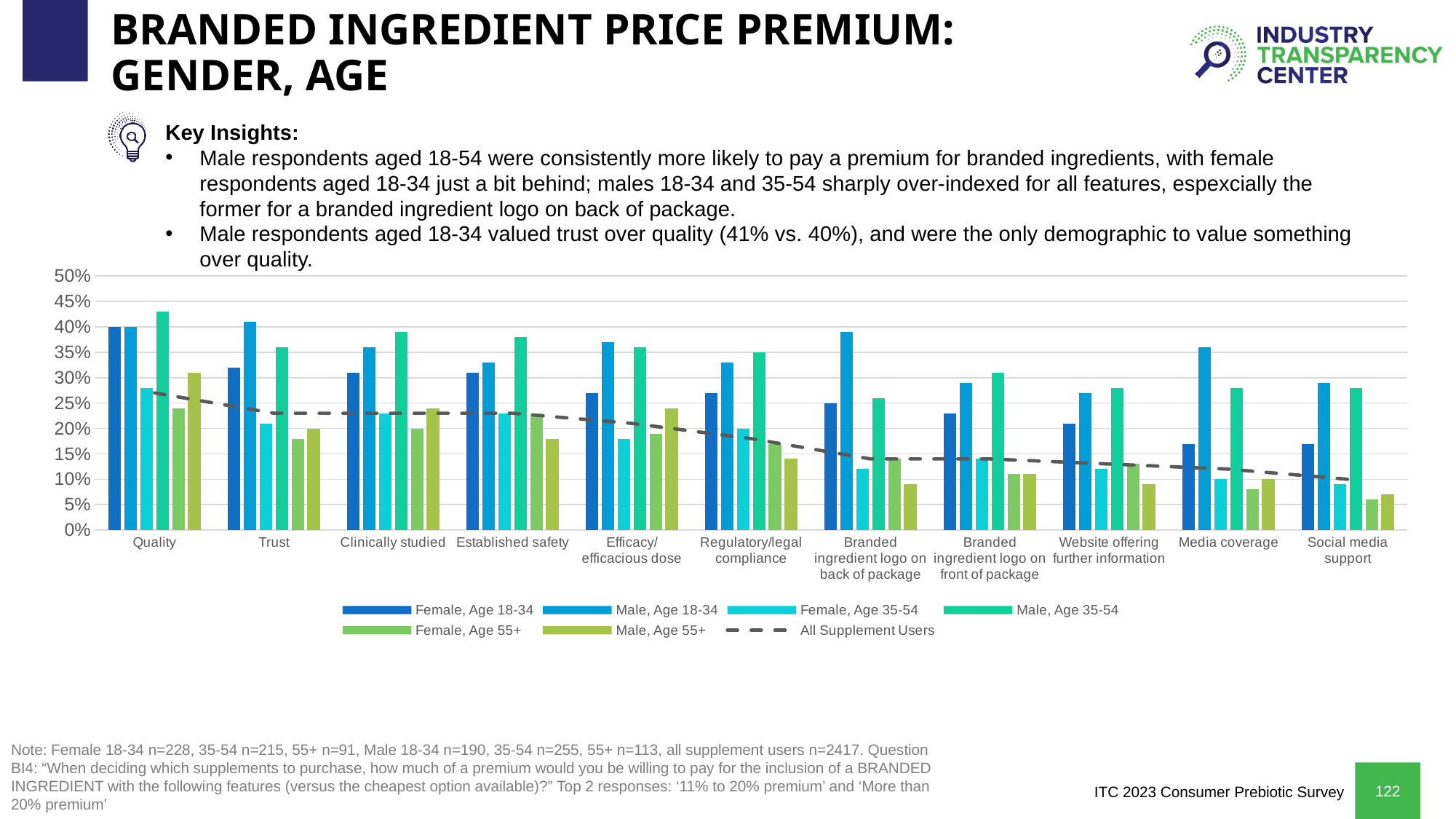
How many series does the chart's legend list? 7 Is the value for Female, Age 18-34 in the Media coverage category greater or less than 20%? less Is the value for Female, Age 55+ in the Social media support category greater or less than 10%? less For the Male, Age 35-54 series, which category has the highest value? Quality Does the All Supplement Users dashed line generally rise or fall from left to right across the categories? Fall Is the value for Male, Age 35-54 in the Quality category greater or less than 40%? greater Which series is represented by the dashed line in the chart? All Supplement Users For the Female, Age 55+ series, which category has the lowest value? Social media support In the Quality category, which is larger: the value for Male, Age 35-54 or the value for Female, Age 55+? Male, Age 35-54 How many categories are shown along the x axis of the chart? 11 What kind of chart is shown on the slide? Combination bar and line chart